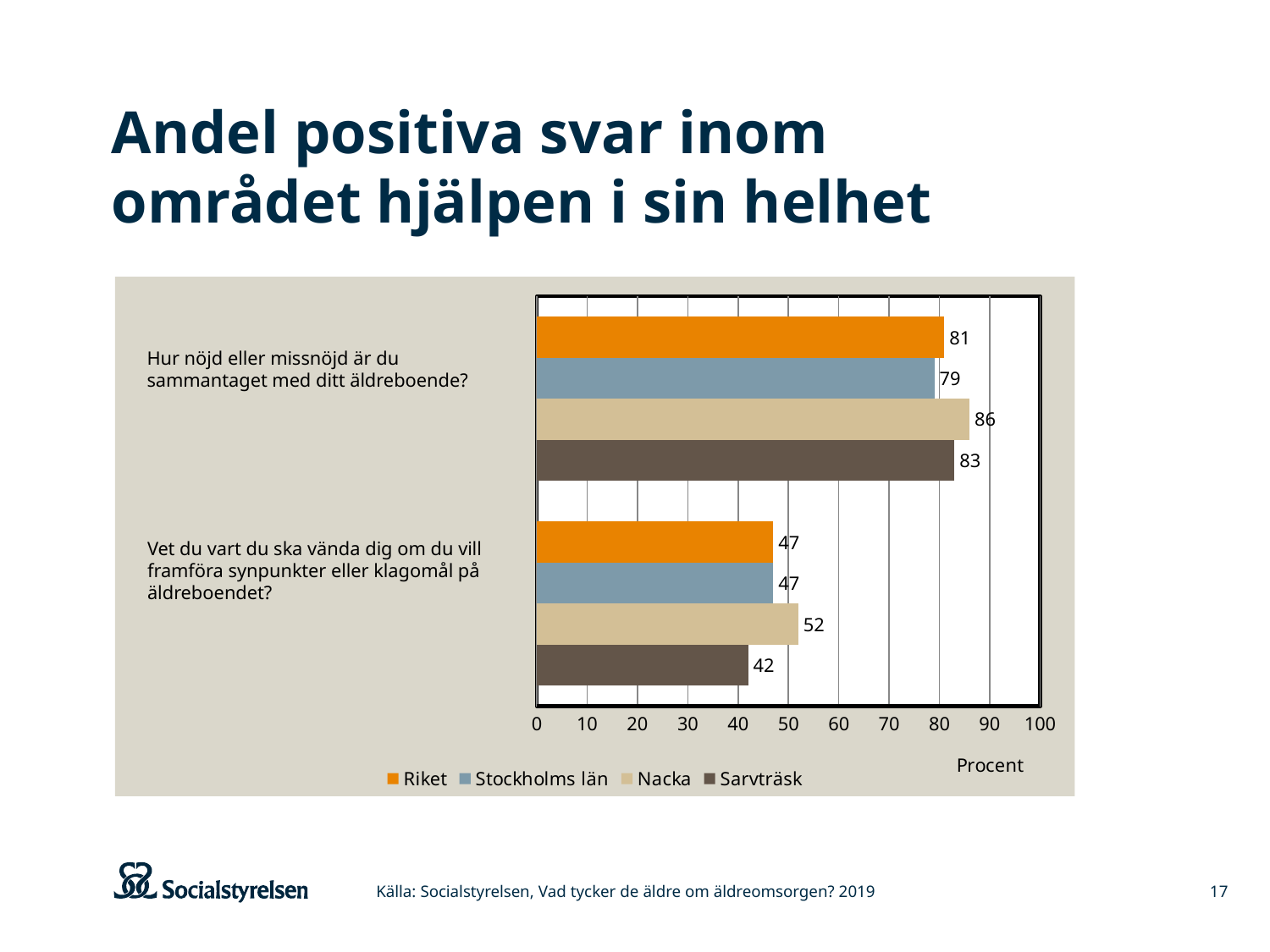
What kind of chart is shown on the slide? Bar chart What value is shown for Riket on the question "Hur nöjd eller missnöjd är du sammantaget med ditt äldreboende?"? 81 Which series has the highest value for the question "Vet du vart du ska vända dig om du vill framföra synpunkter eller klagomål på äldreboendet?"? Nacka What value is shown for Nacka on the question "Hur nöjd eller missnöjd är du sammantaget med ditt äldreboende?"? 86 Is the Sarvträsk value for the question "Hur nöjd eller missnöjd är du sammantaget med ditt äldreboende?" greater or less than 80? greater How many series does the legend list? 4 Which series has the lowest value for the question "Hur nöjd eller missnöjd är du sammantaget med ditt äldreboende?"? Stockholms län What is the difference between the Nacka and Stockholms län values for the question "Hur nöjd eller missnöjd är du sammantaget med ditt äldreboende?"? 7 What value is shown for Sarvträsk on the question "Vet du vart du ska vända dig om du vill framföra synpunkter eller klagomål på äldreboendet?"? 42 What unit is labelled on the horizontal axis of the chart? Procent How many questions (categories) are shown on the chart? 2 For the question "Vet du vart du ska vända dig om du vill framföra synpunkter eller klagomål på äldreboendet?", which is larger: the Nacka value or the Sarvträsk value? Nacka